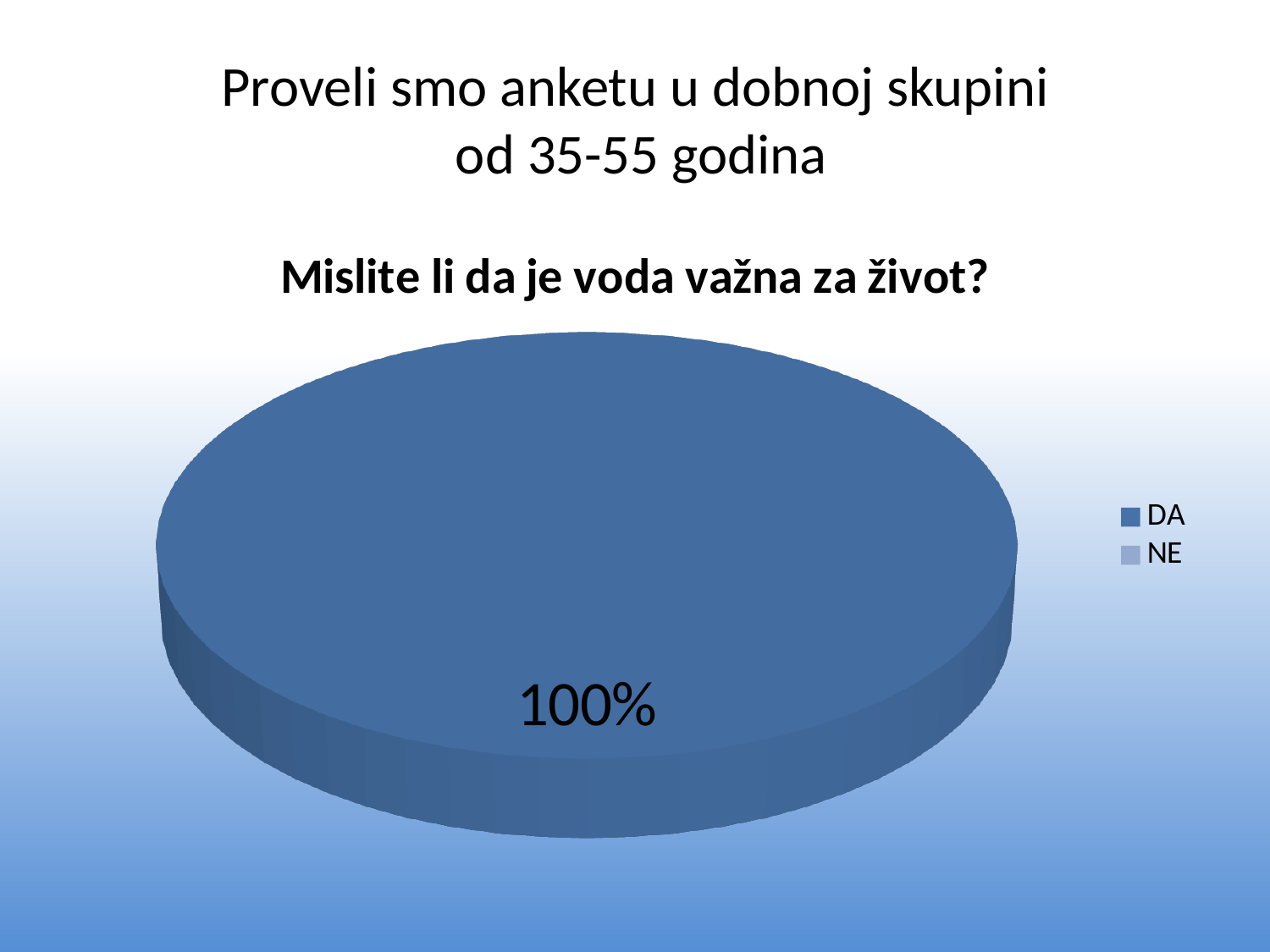
What are the two legend entries? DA and NE What kind of chart is shown on the slide? pie chart How many entries does the legend list? 2 What percentage label is printed on the pie? 100% Which is larger, the share for DA or the share for NE? DA What is the chart's title? Mislite li da je voda važna za život? What share of the pie does DA take? 100% Which category has the largest share of the pie? DA Which category has the smallest share of the pie? NE